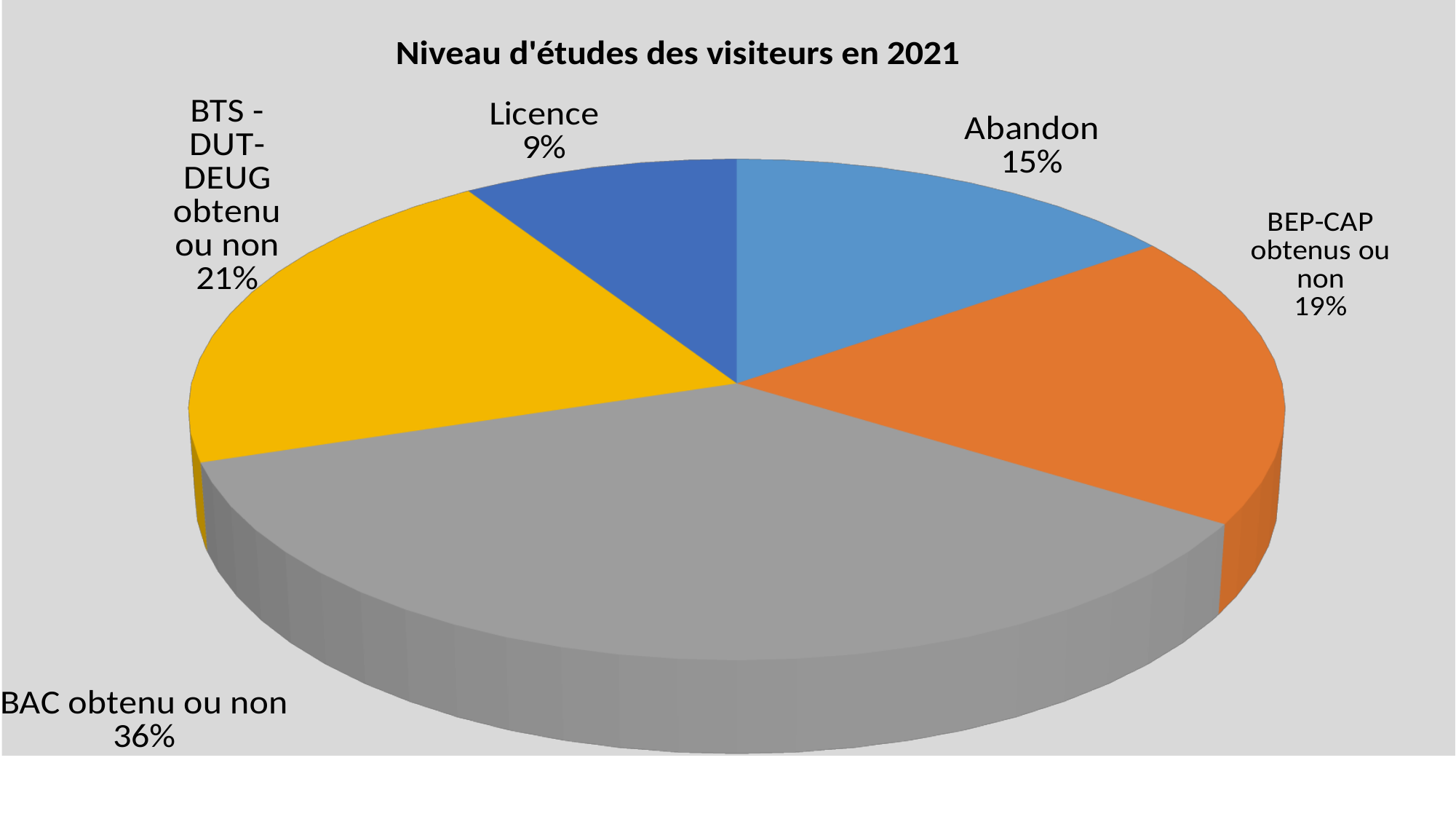
What share of visitors is labelled 'Abandon'? 15% What is the title of the chart? Niveau d'études des visiteurs en 2021 What share of visitors is labelled 'Licence'? 9% How many slices does the pie chart have? 5 What kind of chart is shown on the slide? Pie chart What share of visitors is labelled 'BTS - DUT- DEUG obtenu ou non'? 21% Which category has the largest slice of the pie? BAC obtenu ou non What is the difference in percentage points between 'BAC obtenu ou non' and 'BTS - DUT- DEUG obtenu ou non'? 15 Which is larger, the share for 'Abandon' or the share for 'BEP-CAP obtenus ou non'? BEP-CAP obtenus ou non Which category has the smallest slice of the pie? Licence